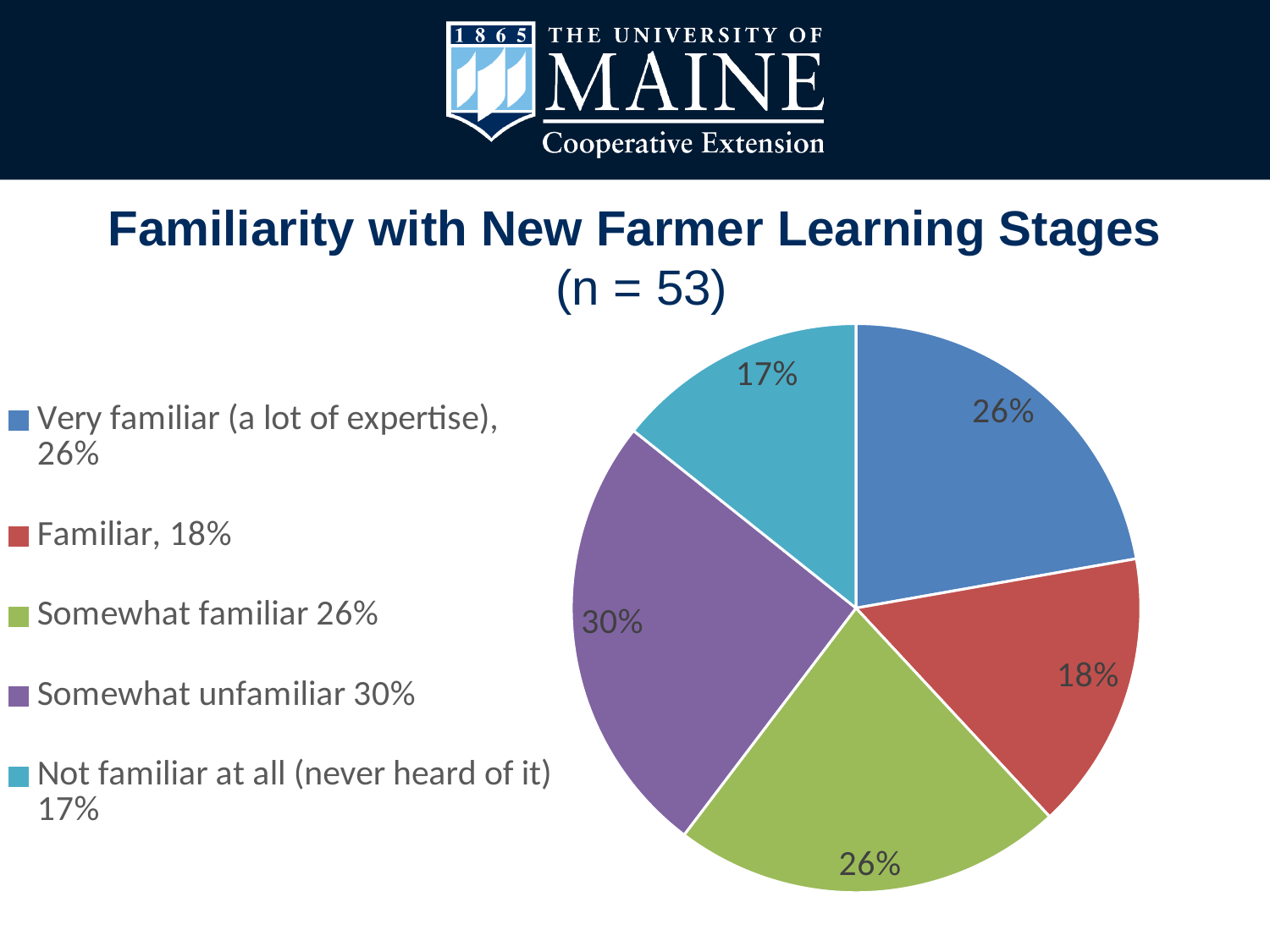
How many categories does the pie chart show? 5 Which is larger, the share for Familiar or the share for Somewhat familiar? Somewhat familiar What is the sample size (n) given in the chart title? 53 What percentage of respondents are Not familiar at all (never heard of it)? 17% What share of respondents are Somewhat unfamiliar with New Farmer Learning Stages? 30% What percentage of respondents are Familiar with New Farmer Learning Stages? 18% What kind of chart is shown on the slide? Pie chart Which category has the smallest share of the pie? Not familiar at all (never heard of it) Which category has the largest share of the pie? Somewhat unfamiliar What is the difference in percentage points between Somewhat unfamiliar and Familiar? 12 What colour is the slice for Somewhat unfamiliar? Purple What percentage of respondents are Very familiar (a lot of expertise)? 26%